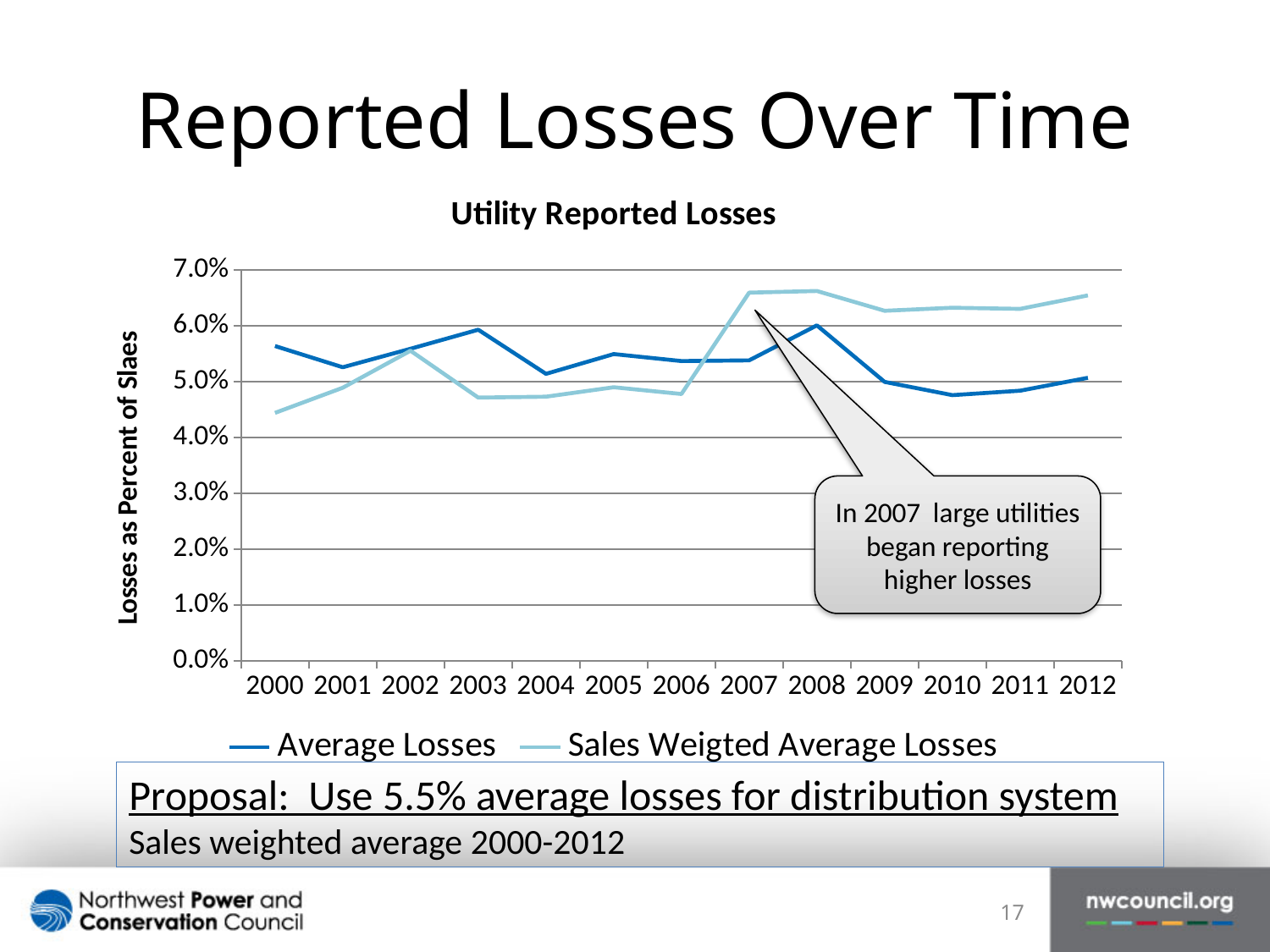
How many years are plotted along the x axis? 13 Does the Sales Weigted Average Losses series rise or fall from 2006 to 2007? rise Is the value for Average Losses in 2003 greater or less than 5.0%? greater Is the value for Sales Weigted Average Losses in 2000 greater or less than 5.0%? less How many series does the legend list? 2 Is the value for Sales Weigted Average Losses in 2007 greater or less than 6.0%? greater What is the title of the chart? Utility Reported Losses What is the label on the vertical axis? Losses as Percent of Slaes In which year is the Sales Weigted Average Losses series at its lowest? 2000 What kind of chart is shown on the slide? line chart In 2012, which series has the higher value, Average Losses or Sales Weigted Average Losses? Sales Weigted Average Losses